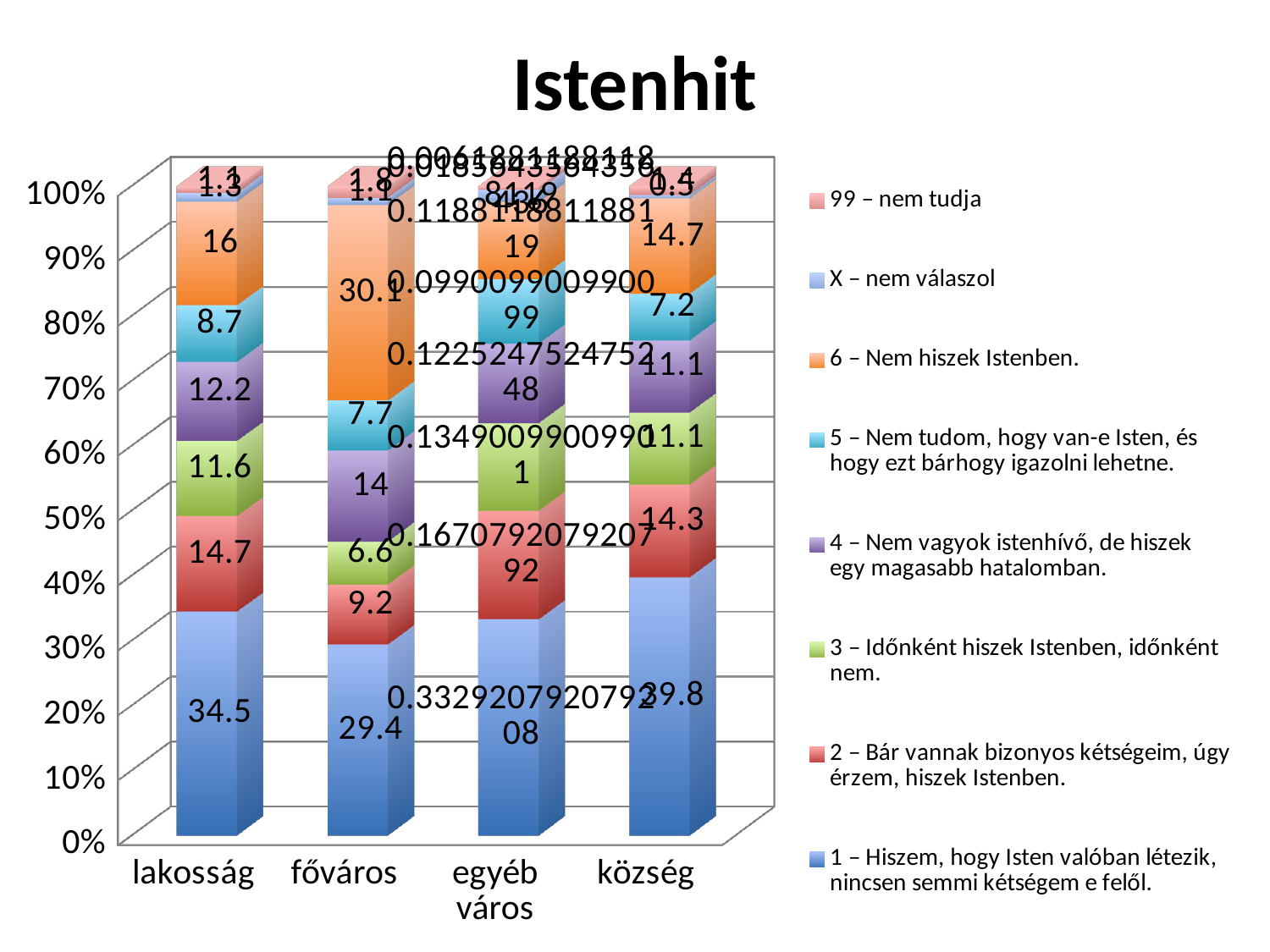
In the series "1 – Hiszem, hogy Isten valóban létezik, nincsen semmi kétségem e felől.", which is larger: főváros or község? község Which category has the lowest value in the series "1 – Hiszem, hogy Isten valóban létezik, nincsen semmi kétségem e felől."? főváros What is the value for főváros in the series "6 – Nem hiszek Istenben."? 30.1 How many categories are shown on the x axis of the chart? 4 What is the value for lakosság in the series "1 – Hiszem, hogy Isten valóban létezik, nincsen semmi kétségem e felől."? 34.5 What is the title of the chart? Istenhit How many series does the legend list? 8 What kind of chart is shown on the slide? stacked bar chart What is the value for lakosság in the series "2 – Bár vannak bizonyos kétségeim, úgy érzem, hiszek Istenben."? 14.7 What is the value for község in the series "1 – Hiszem, hogy Isten valóban létezik, nincsen semmi kétségem e felől."? 39.8 What is the difference between lakosság and főváros in the series "1 – Hiszem, hogy Isten valóban létezik, nincsen semmi kétségem e felől."? 5.1 Which category has the highest value in the series "6 – Nem hiszek Istenben."? főváros